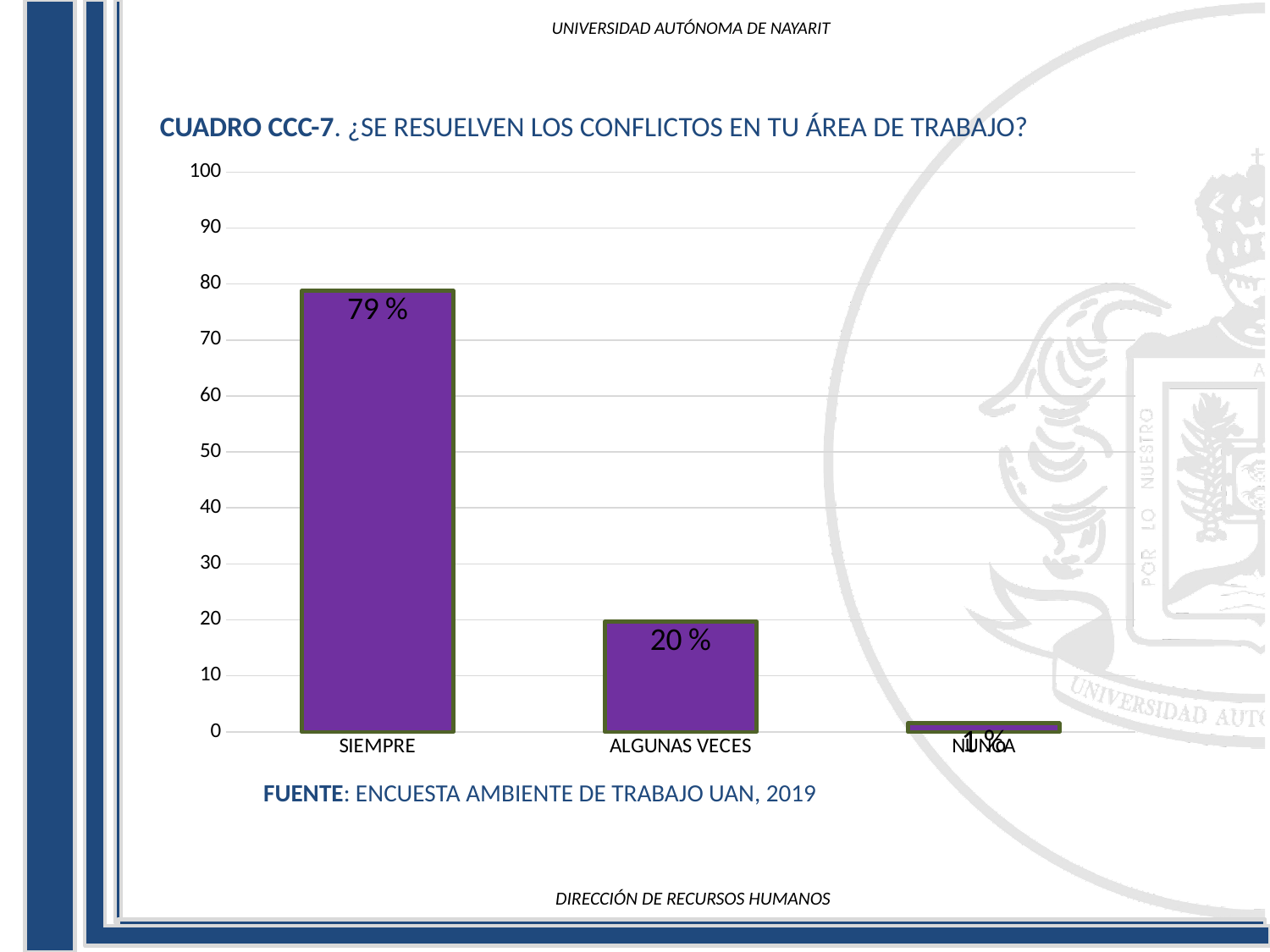
What is the value for NUNCA? 1 % Is the value for SIEMPRE greater or less than 70? greater What is the difference between the values for SIEMPRE and ALGUNAS VECES? 59 % How many categories are shown on the x axis? 3 What is the value for SIEMPRE? 79 % What is the difference between the values for ALGUNAS VECES and NUNCA? 19 % What kind of chart is shown on the slide? bar chart What is the title of the chart? CUADRO CCC-7. ¿SE RESUELVEN LOS CONFLICTOS EN TU ÁREA DE TRABAJO? What is the value for ALGUNAS VECES? 20 % Which category has the highest value? SIEMPRE Which is larger, the value for ALGUNAS VECES or the value for NUNCA? ALGUNAS VECES Which category has the lowest value? NUNCA